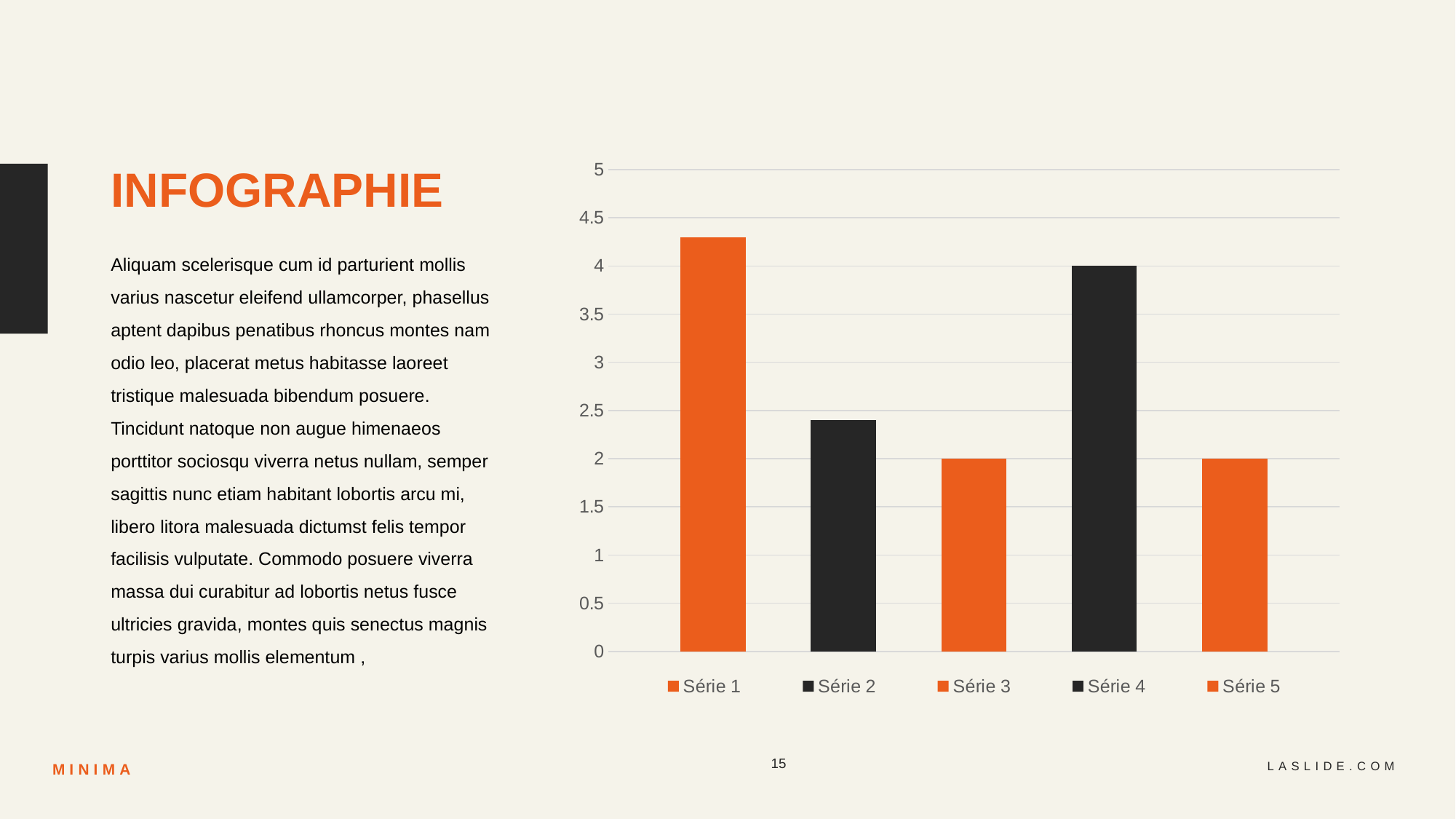
What is the value for Série 3? 2 Is the value for Série 1 greater or less than 4? greater What colour is the bar for Série 2? black What is the difference between the values for Série 4 and Série 3? 2 What is the value for Série 5? 2 Which is larger, the value for Série 2 or the value for Série 4? Série 4 What type of chart is shown on the slide? bar chart Is the value for Série 2 greater or less than 2.5? less How many series does the legend list? 5 How many bars are plotted in the chart? 5 Which series has the highest value? Série 1 What is the value for Série 4? 4